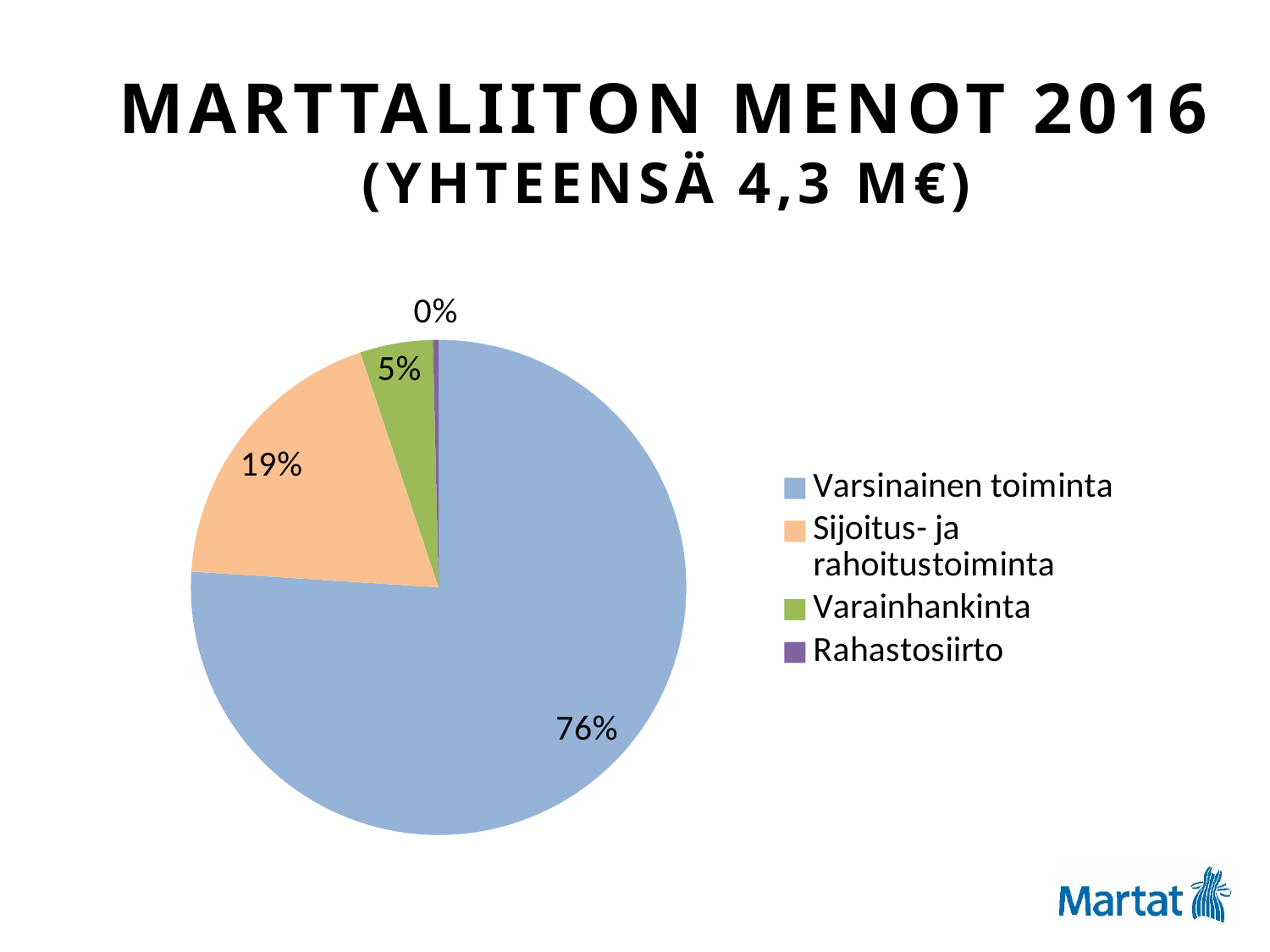
What kind of chart is shown on the slide? pie chart What is the title of the chart on the slide? MARTTALIITON MENOT 2016 (YHTEENSÄ 4,3 M€) Which is larger, the share for Sijoitus- ja rahoitustoiminta or the share for Varainhankinta? Sijoitus- ja rahoitustoiminta Which category has the smallest slice of the pie? Rahastosiirto What colour is the slice for Varainhankinta? green Which category has the largest slice of the pie? Varsinainen toiminta What share of the pie does Varainhankinta take? 5% How many categories does the legend list? 4 What is the difference in percentage points between Varsinainen toiminta and Sijoitus- ja rahoitustoiminta? 57 What share of the pie does Rahastosiirto take? 0% What share of the pie does Sijoitus- ja rahoitustoiminta take? 19%